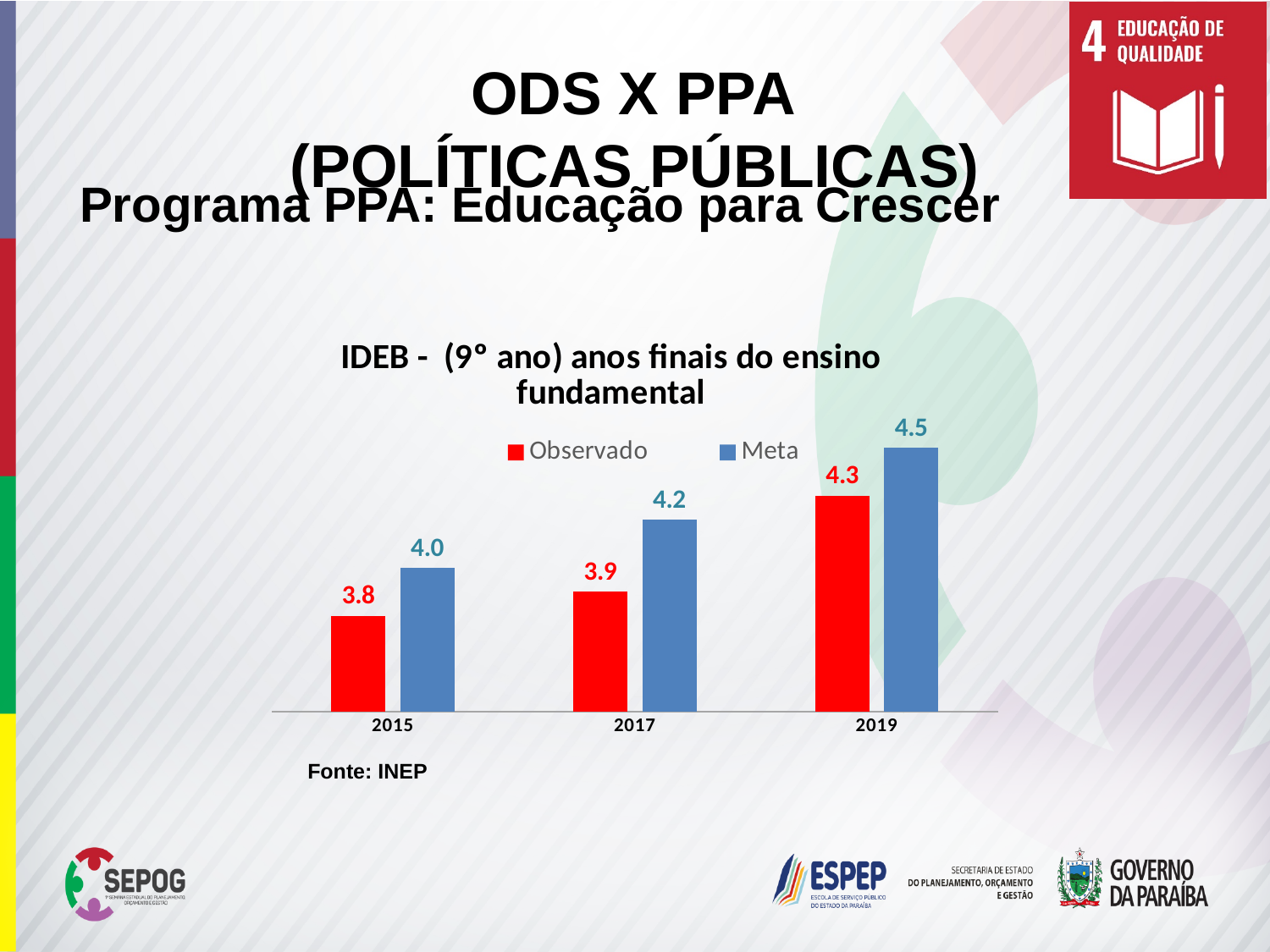
How many years are shown on the x axis? 3 What kind of chart is shown on the slide? Bar chart What is the Observado value for 2019? 4.3 Which year has the lowest Meta value? 2015 What is the Meta value for 2017? 4.2 What is the Observado value for 2015? 3.8 What is the Meta value for 2019? 4.5 Which is larger in 2015, the Observado value or the Meta value? Meta Which year has the highest Observado value? 2019 Do the Observado values rise or fall from 2015 to 2019? Rise What is the difference between the Meta and Observado values in 2017? 0.3 How many series does the legend list? 2